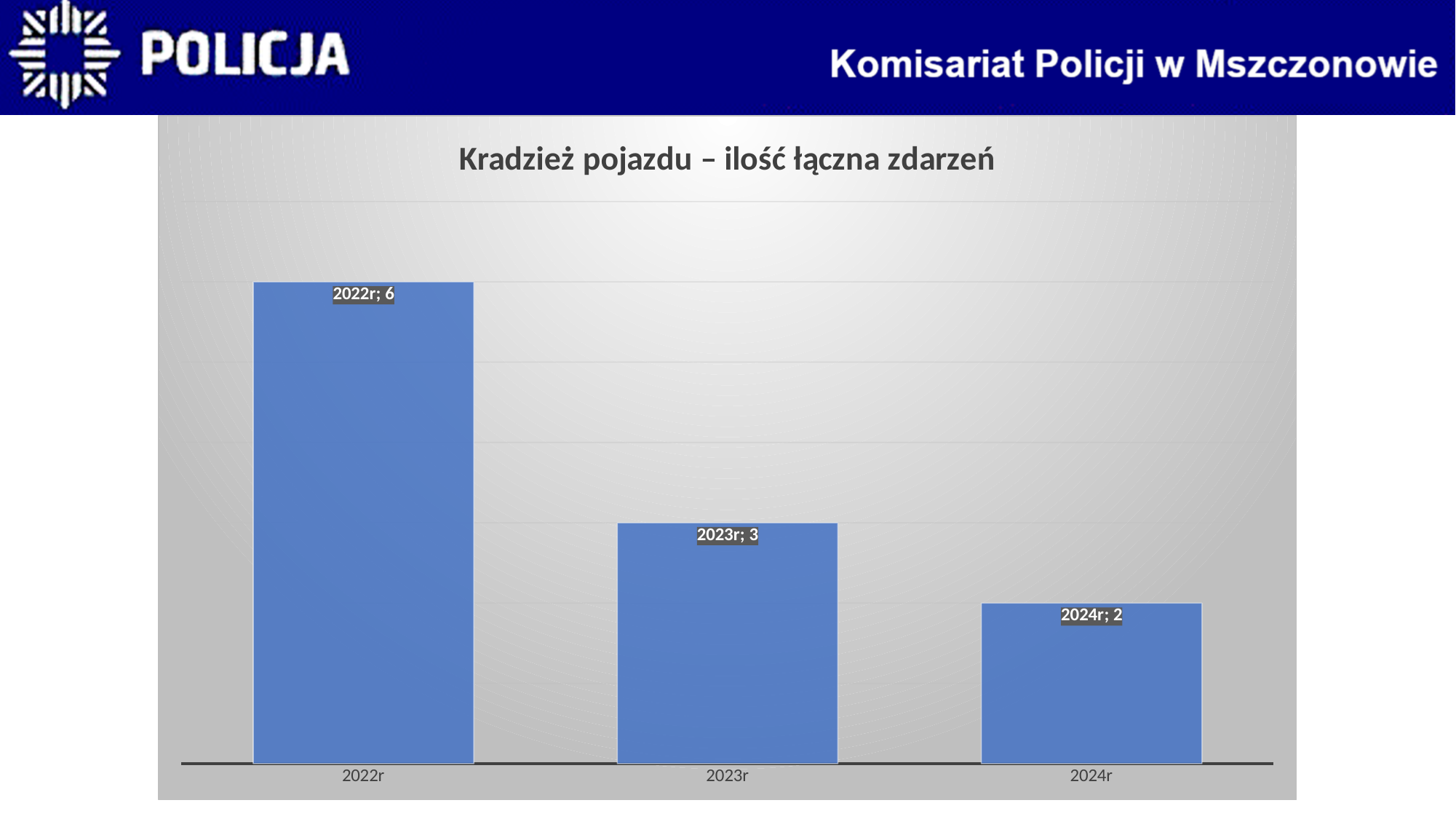
What kind of chart is shown on the slide? bar chart What is the title of the chart? Kradzież pojazdu – ilość łączna zdarzeń How many categories are shown on the chart? 3 What is the value for 2023r? 3 What is the difference between the values for 2023r and 2024r? 1 What is the value for 2024r? 2 Do the values rise or fall from 2022r to 2024r? fall What is the value for 2022r? 6 What is the difference between the values for 2022r and 2023r? 3 Which year has the highest value? 2022r Which year has the lowest value? 2024r Which is larger, the value for 2022r or the value for 2024r? 2022r